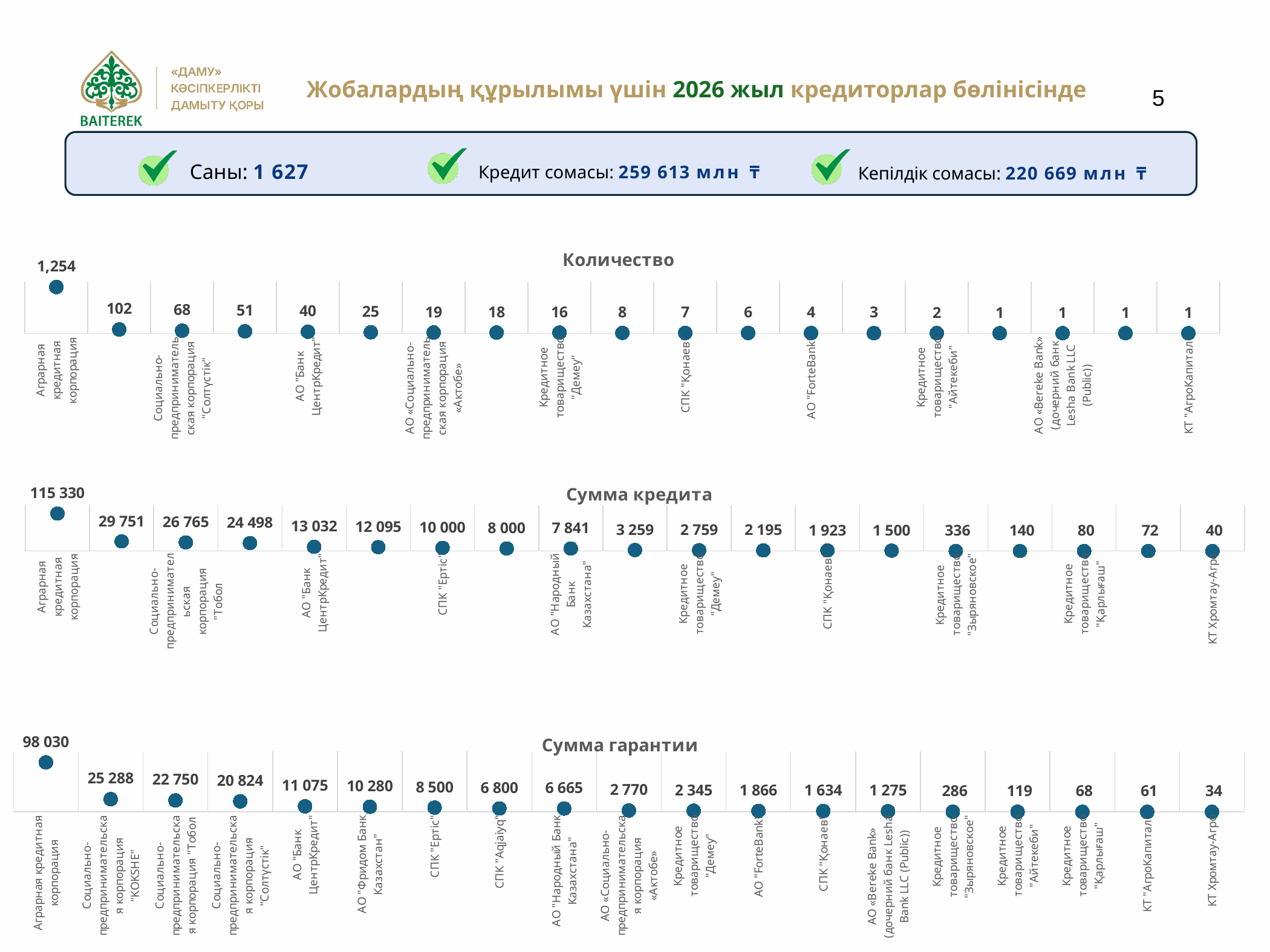
How many charts are shown on the slide? 3 In the "Количество" chart, how many data points are plotted? 19 In the "Сумма кредита" chart, which category has the lowest value? КТ Хромтау-Агро In the "Сумма гарантии" chart, which is larger: the value for СПК "Ертіс" or the value for СПК "Aqjaiyq"? СПК "Ертіс" In the "Сумма гарантии" chart, what is the value for КТ "АгроКапитал"? 61 In the "Сумма кредита" chart, what is the value for Кредитное товарищество "Демеу"? 2 759 In the "Сумма гарантии" chart, what is the value for АО "Фридом Банк Казахстан"? 10 280 In the "Количество" chart, which category has the highest value? Аграрная кредитная корпорация In the "Количество" chart, what is the value for Аграрная кредитная корпорация? 1,254 In the "Сумма гарантии" chart, what is the difference between the values for Социально-предпринимательская корпорация "Тобол" and Социально-предпринимательская корпорация "Солтүстік"? 1 926 In the "Количество" chart, what is the value for АО "Банк ЦентрКредит"? 40 In the "Сумма кредита" chart, what is the value for СПК "Ертіс"? 10 000